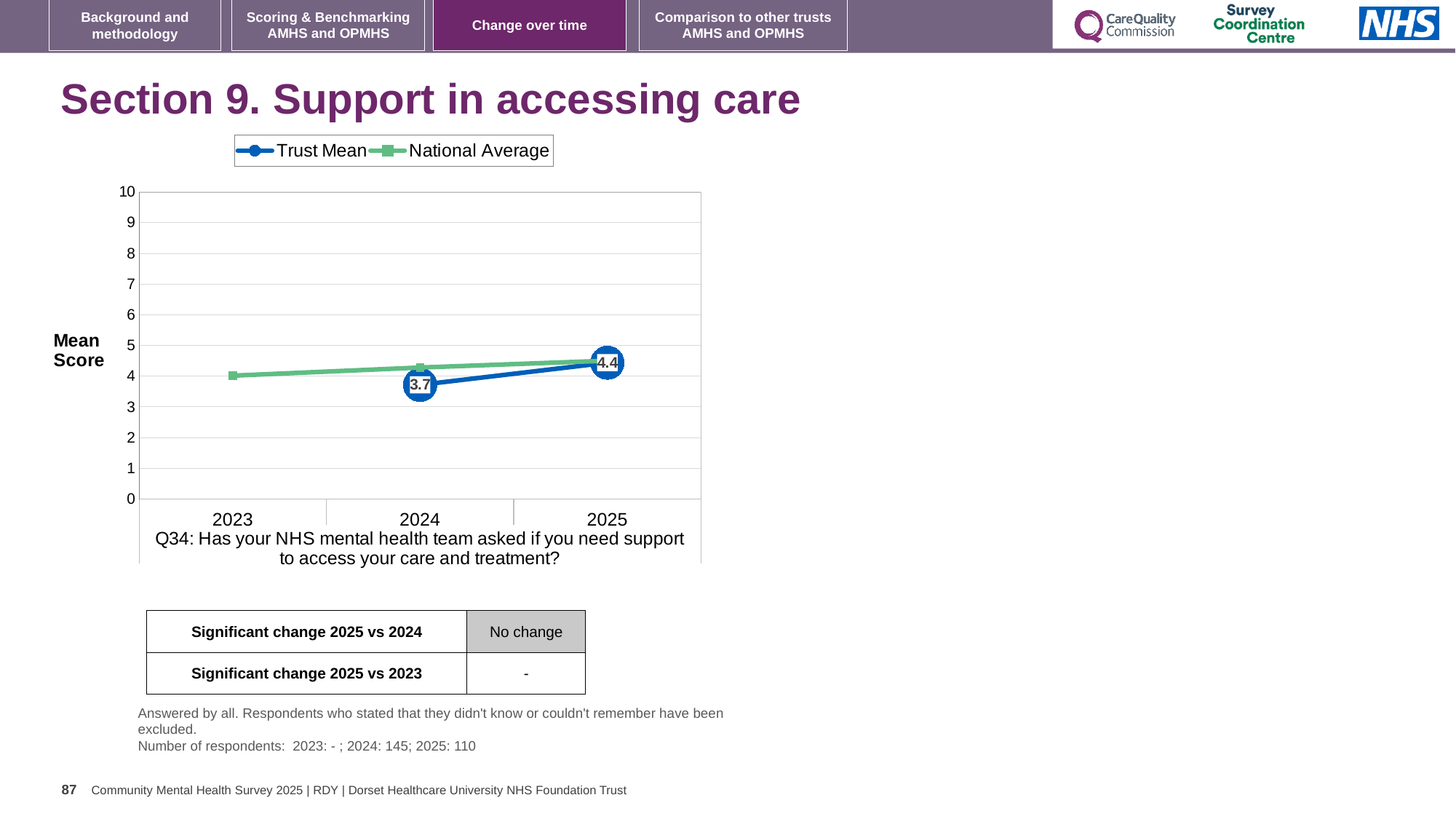
How many years are shown on the x axis? 3 By how much did the Trust Mean change from 2024 to 2025? 0.7 What kind of chart is shown on the slide? line chart In 2024, which series is higher: Trust Mean or National Average? National Average What is the label on the y axis of the chart? Mean Score How many series does the legend list? 2 What is the Trust Mean value for 2025? 4.4 Which year has the higher Trust Mean, 2024 or 2025? 2025 Does the Trust Mean rise or fall from 2024 to 2025? rise What is the Trust Mean value for 2024? 3.7 Is the National Average value for 2023 greater or less than 5? less Which series is shown in green in the legend? National Average